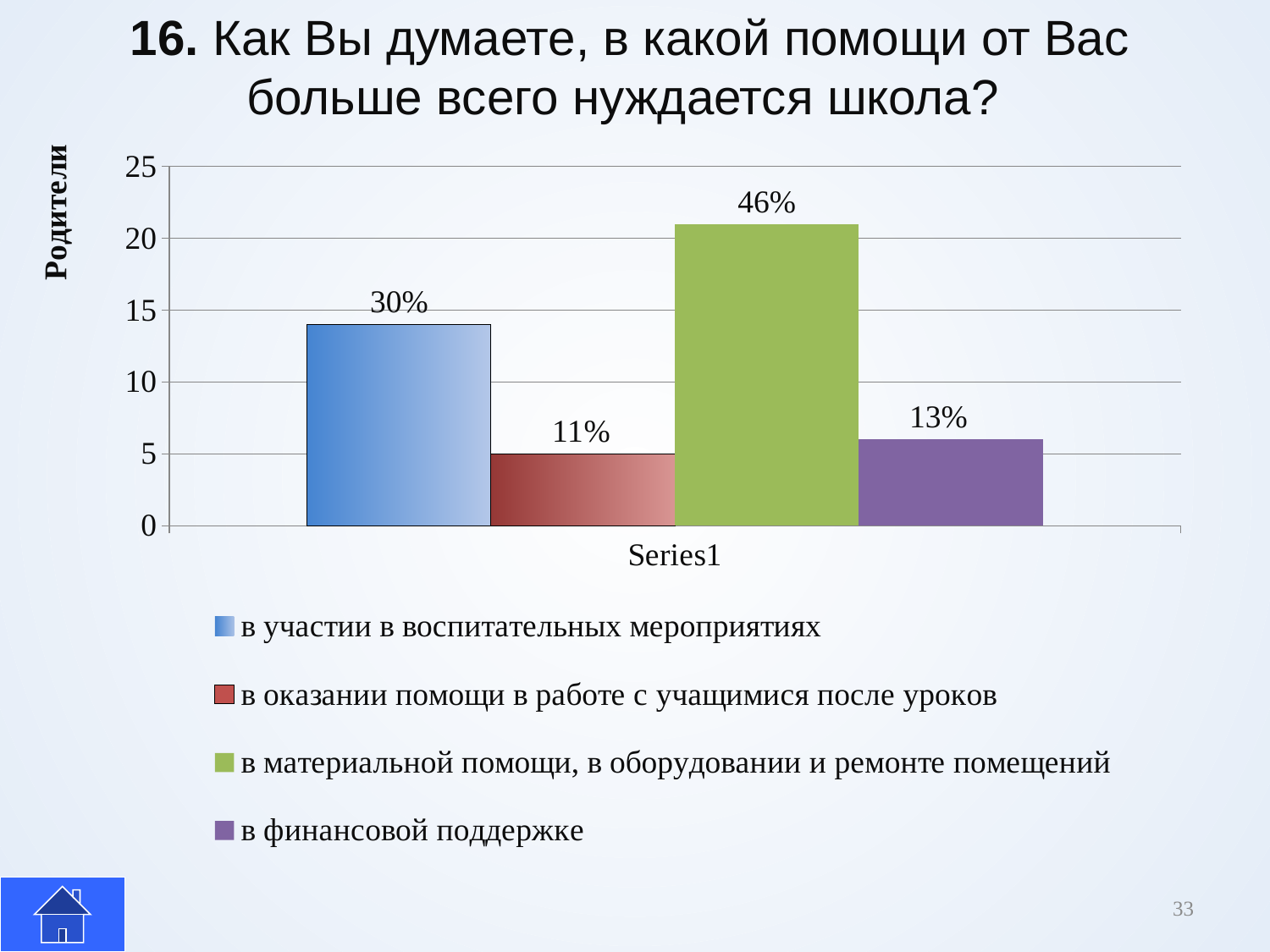
What data label is shown on the bar for «в материальной помощи, в оборудовании и ремонте помещений»? 46% On the vertical axis, is the bar for «в финансовой поддержке» greater or less than 10? less How many bars are plotted in the chart? 4 What type of chart is shown on the slide? bar chart What is the difference between the data labels for «в материальной помощи, в оборудовании и ремонте помещений» and «в участии в воспитательных мероприятиях»? 16% On the vertical axis, is the bar for «в участии в воспитательных мероприятиях» greater or less than 10? greater Which is larger: the bar for «в финансовой поддержке» or the bar for «в оказании помощи в работе с учащимися после уроков»? в финансовой поддержке What data label is shown on the bar for «в финансовой поддержке»? 13% Which category has the lowest bar? в оказании помощи в работе с учащимися после уроков What data label is shown on the bar for «в участии в воспитательных мероприятиях»? 30% What data label is shown on the bar for «в оказании помощи в работе с учащимися после уроков»? 11% Which category has the highest bar? в материальной помощи, в оборудовании и ремонте помещений